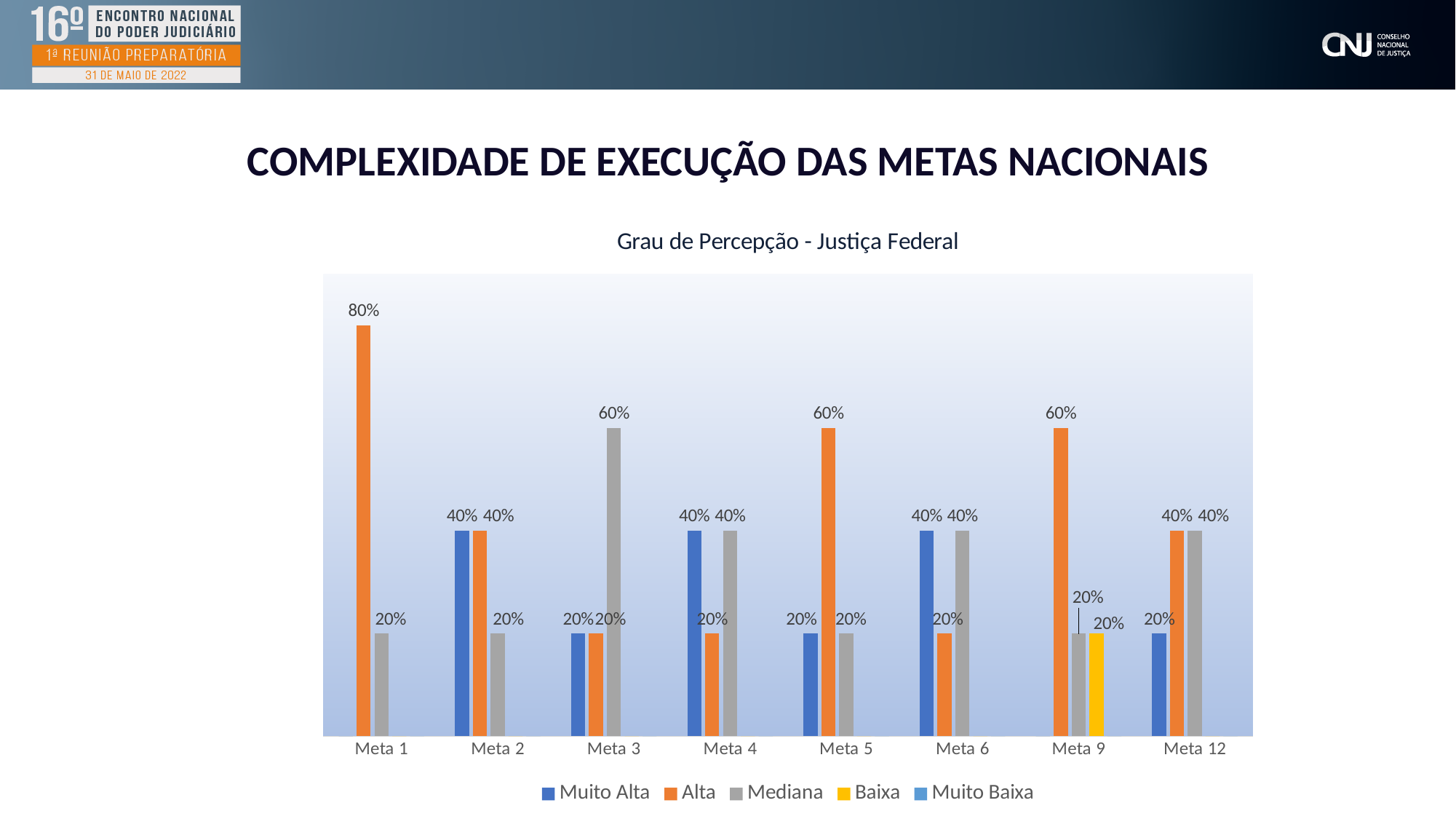
Which Meta is the only one with a Baixa bar? Meta 9 What is the title of the chart? Grau de Percepção - Justiça Federal What is the difference between the Alta value and the Mediana value for Meta 1? 60% For Meta 5, which is larger: Alta or Muito Alta? Alta What is the value of Baixa for Meta 9? 20% What type of chart is shown on the slide? Bar chart What is the value of Mediana for Meta 3? 60% What is the value of Muito Alta for Meta 12? 20% What is the value of Alta for Meta 1? 80% How many Metas (categories) are shown on the x axis? 8 How many series does the legend list? 5 Which Meta has the highest Alta value? Meta 1